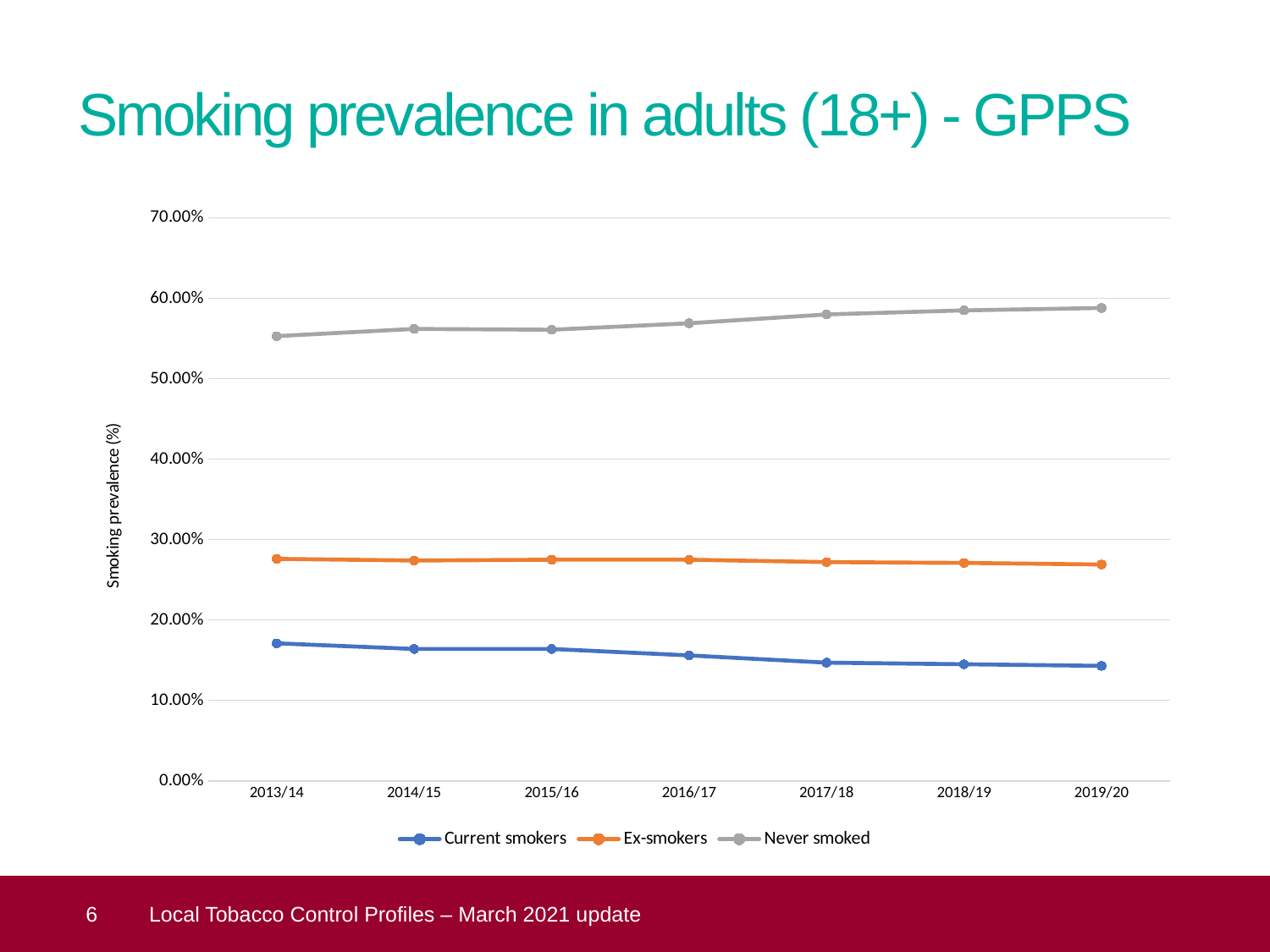
In which year is the Current smokers value highest? 2013/14 Is the value for Never smoked in 2019/20 greater or less than 60.00%? less Does the Never smoked line rise or fall from 2013/14 to 2019/20? Rise Which series has the larger value in 2017/18, Ex-smokers or Current smokers? Ex-smokers How many series does the legend list? 3 Is the value for Current smokers in 2019/20 greater or less than 20.00%? less Is the value for Never smoked in 2013/14 greater or less than 50.00%? greater In which year is the Never smoked value lowest? 2013/14 How many years are plotted along the x axis? 7 Does the Current smokers line rise or fall from 2013/14 to 2019/20? Fall What kind of chart is shown on the slide? Line chart